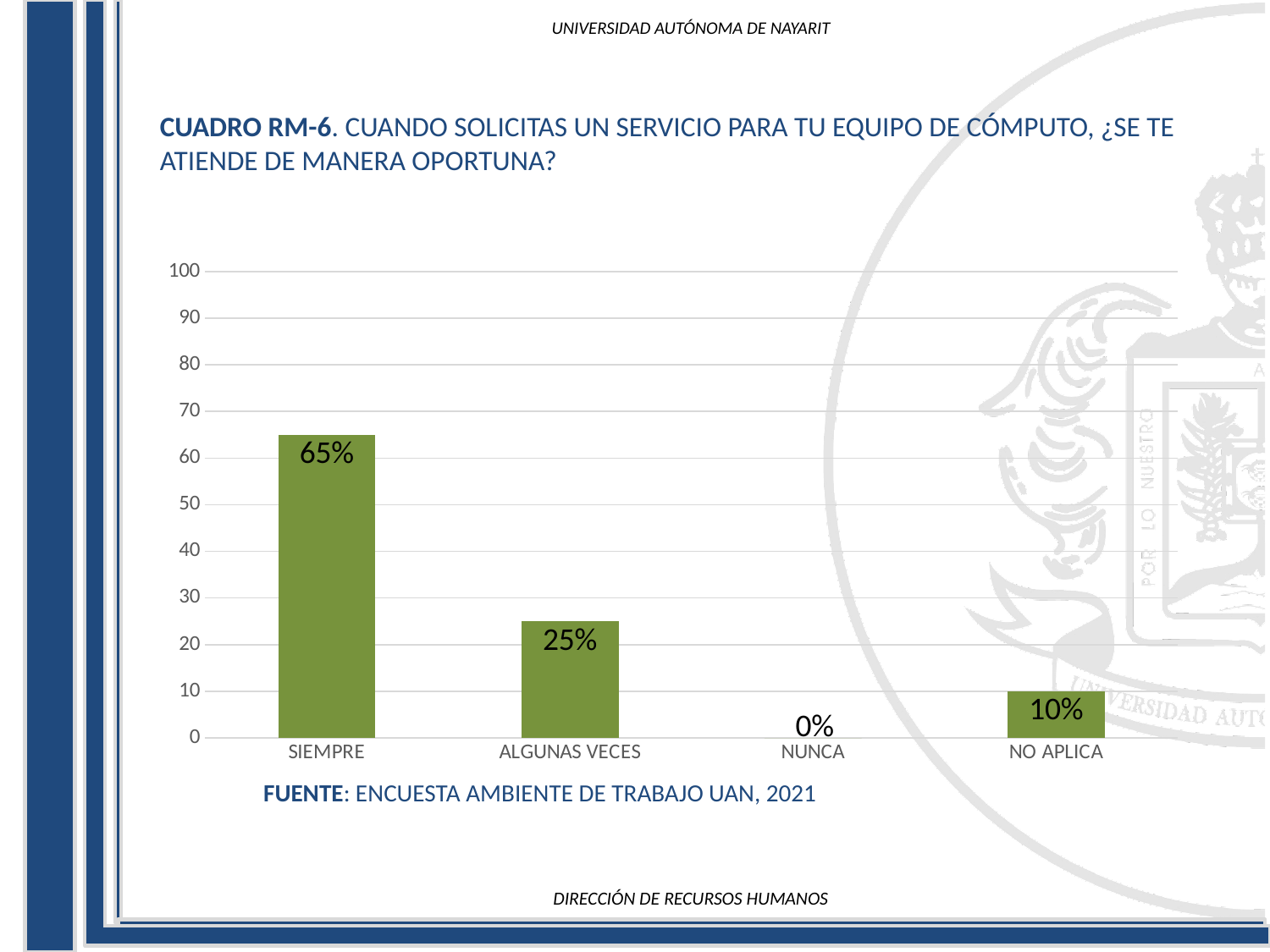
What is the value for SIEMPRE? 65% What is the value for ALGUNAS VECES? 25% What source is cited below the chart? ENCUESTA AMBIENTE DE TRABAJO UAN, 2021 How many categories are shown on the x axis? 4 What kind of chart is shown on the slide? bar chart Is the value for SIEMPRE greater or less than 50? greater What is the difference between the values for SIEMPRE and ALGUNAS VECES? 40% What is the value for NUNCA? 0% Which category has the lowest value? NUNCA Which is larger, the value for ALGUNAS VECES or the value for NO APLICA? ALGUNAS VECES Which category has the highest value? SIEMPRE What is the value for NO APLICA? 10%